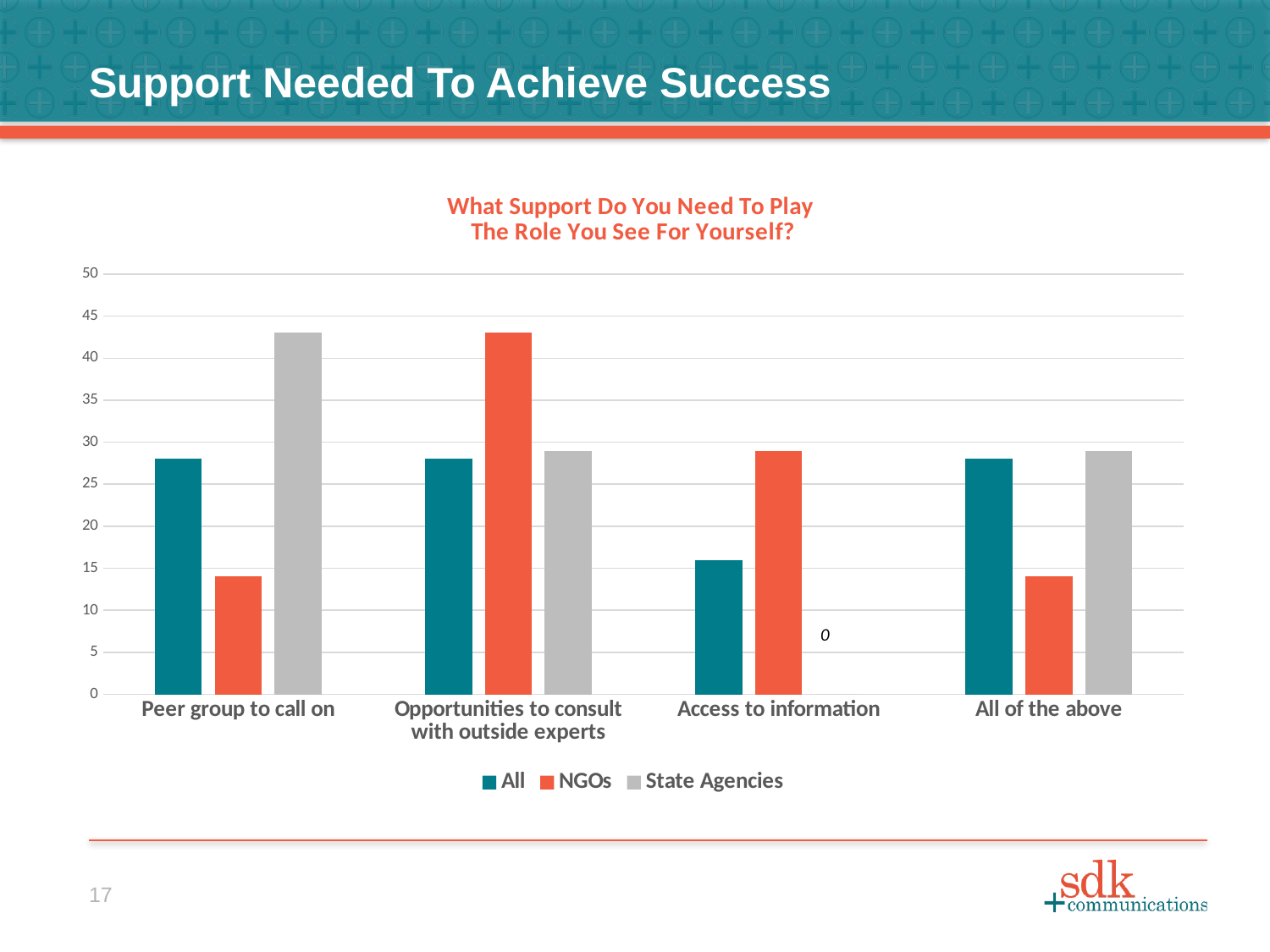
How many series does the legend list? 3 Is the value for State Agencies in 'Peer group to call on' greater or less than 40? greater In the 'All of the above' category, which is larger: the value for All or the value for NGOs? All Which series has the lowest value in the 'Access to information' category? State Agencies Which series has the highest value in the 'Peer group to call on' category? State Agencies What is the value for State Agencies in the 'Access to information' category? 0 What kind of chart is shown on the slide? bar chart Is the value for NGOs in 'Opportunities to consult with outside experts' greater or less than 40? greater What is the title of the chart? What Support Do You Need To Play The Role You See For Yourself? How many categories are shown on the x axis? 4 Is the value for NGOs in 'Peer group to call on' greater or less than 20? less